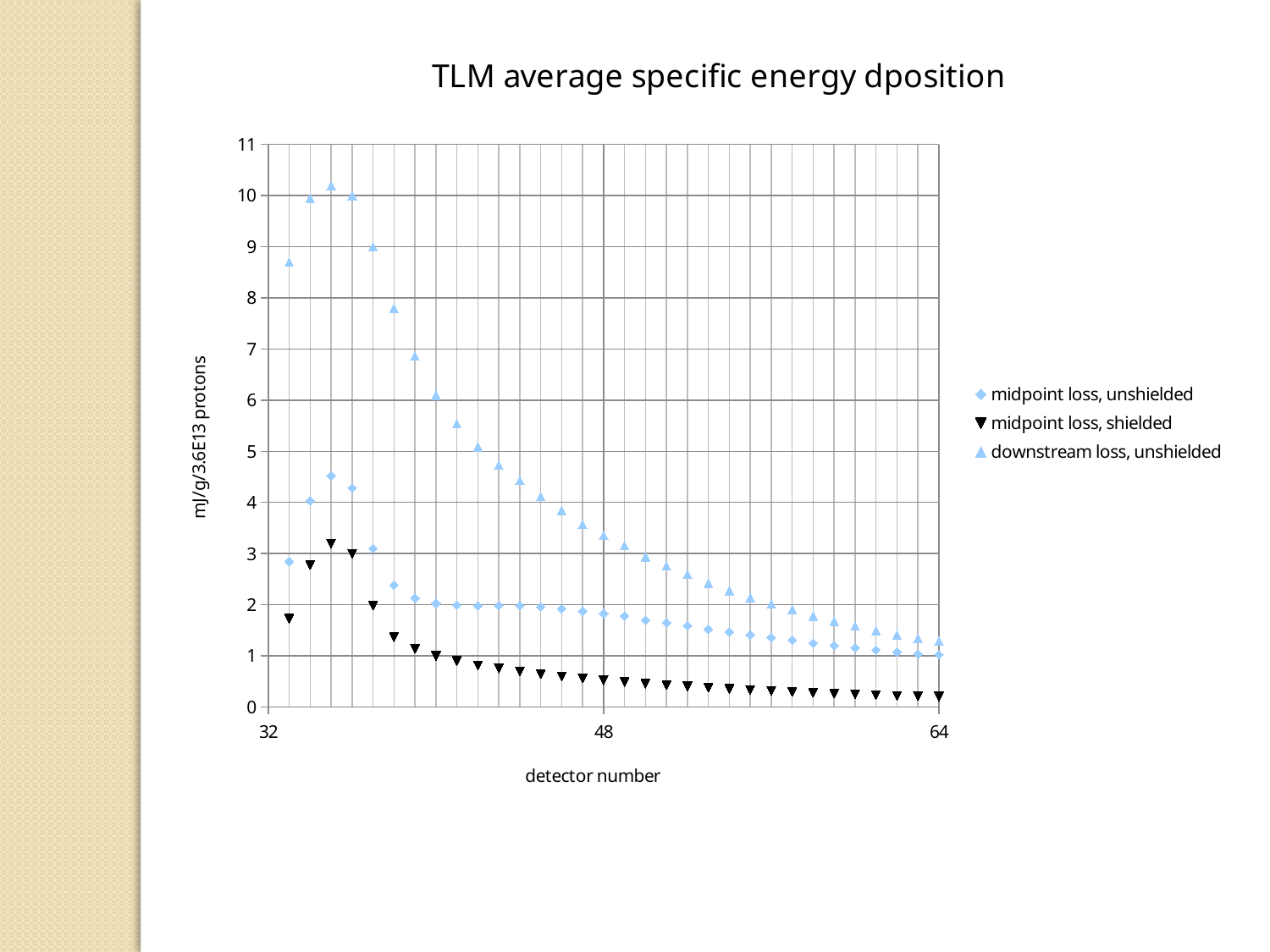
What is the title of the chart? TLM average specific energy dposition Is the value for midpoint loss, unshielded at detector number 48 greater or less than 2? less How many series does the legend list? 3 Is the value for midpoint loss, shielded at detector number 48 greater or less than 1? less Which series has the lowest values across the chart? midpoint loss, shielded What is the label of the x axis? detector number Is the value for downstream loss, unshielded at detector number 48 greater or less than 3? greater Which series reaches the highest value on the chart? downstream loss, unshielded At detector number 48, which is larger: downstream loss, unshielded or midpoint loss, shielded? downstream loss, unshielded From detector number 48 to 64, do the values of downstream loss, unshielded rise or fall? fall What kind of chart is shown on the slide? scatter chart